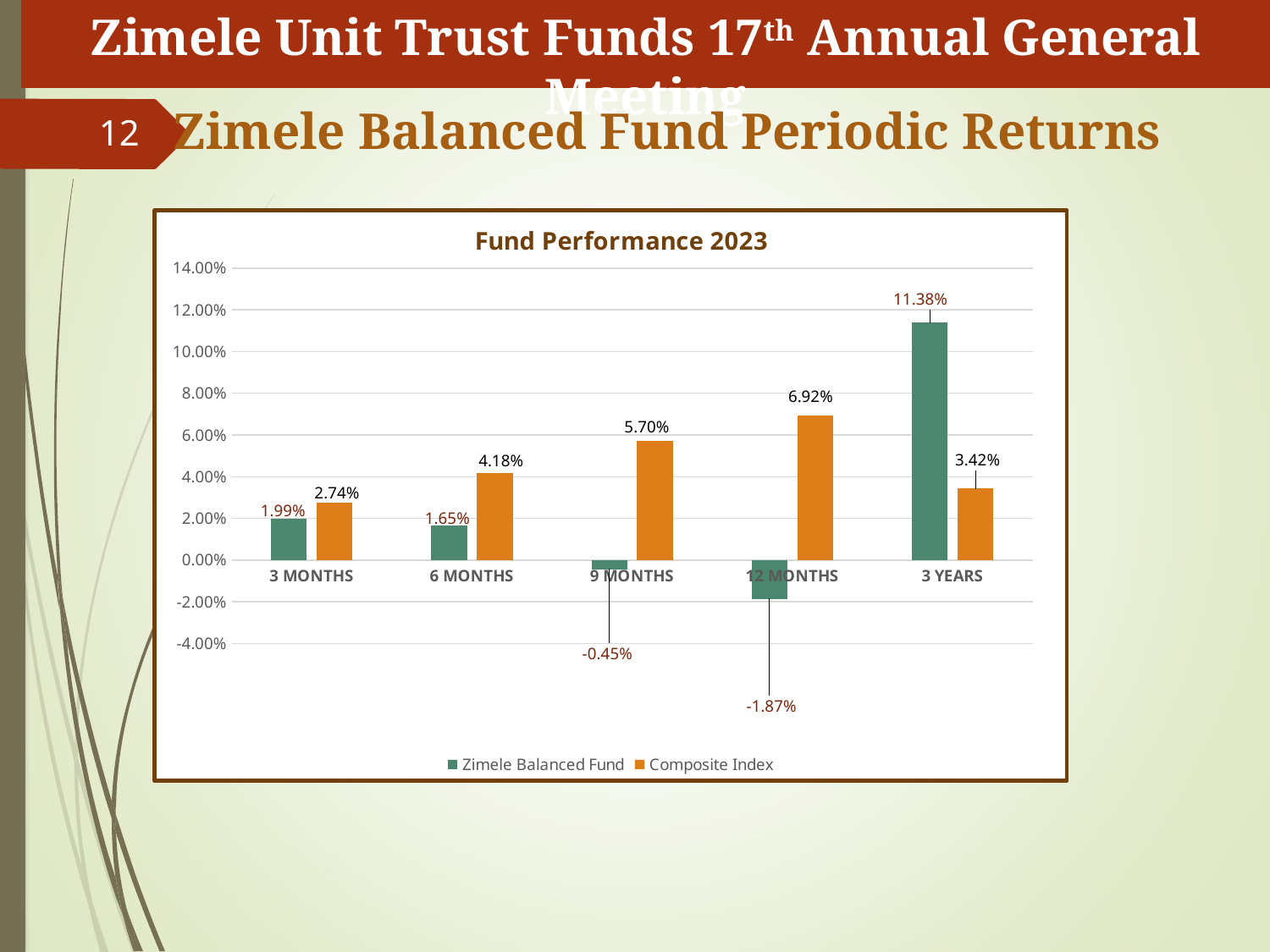
Which category has the lowest value for Zimele Balanced Fund? 12 MONTHS How many series does the legend of the "Fund Performance 2023" chart list? 2 At 3 YEARS, which is larger: Zimele Balanced Fund or Composite Index? Zimele Balanced Fund What is the value for Composite Index at 12 MONTHS? 6.92% What is the difference between the Composite Index and Zimele Balanced Fund values at 6 MONTHS? 2.53% What is the value for Zimele Balanced Fund at 9 MONTHS? -0.45% Do the Composite Index values rise or fall from 3 MONTHS to 12 MONTHS? rise What type of chart is shown under the title "Fund Performance 2023"? bar chart What colour are the Composite Index bars in the "Fund Performance 2023" chart? orange Which category has the highest value for Composite Index? 12 MONTHS How many categories are shown on the x axis of the "Fund Performance 2023" chart? 5 What is the value for Zimele Balanced Fund at 3 YEARS? 11.38%